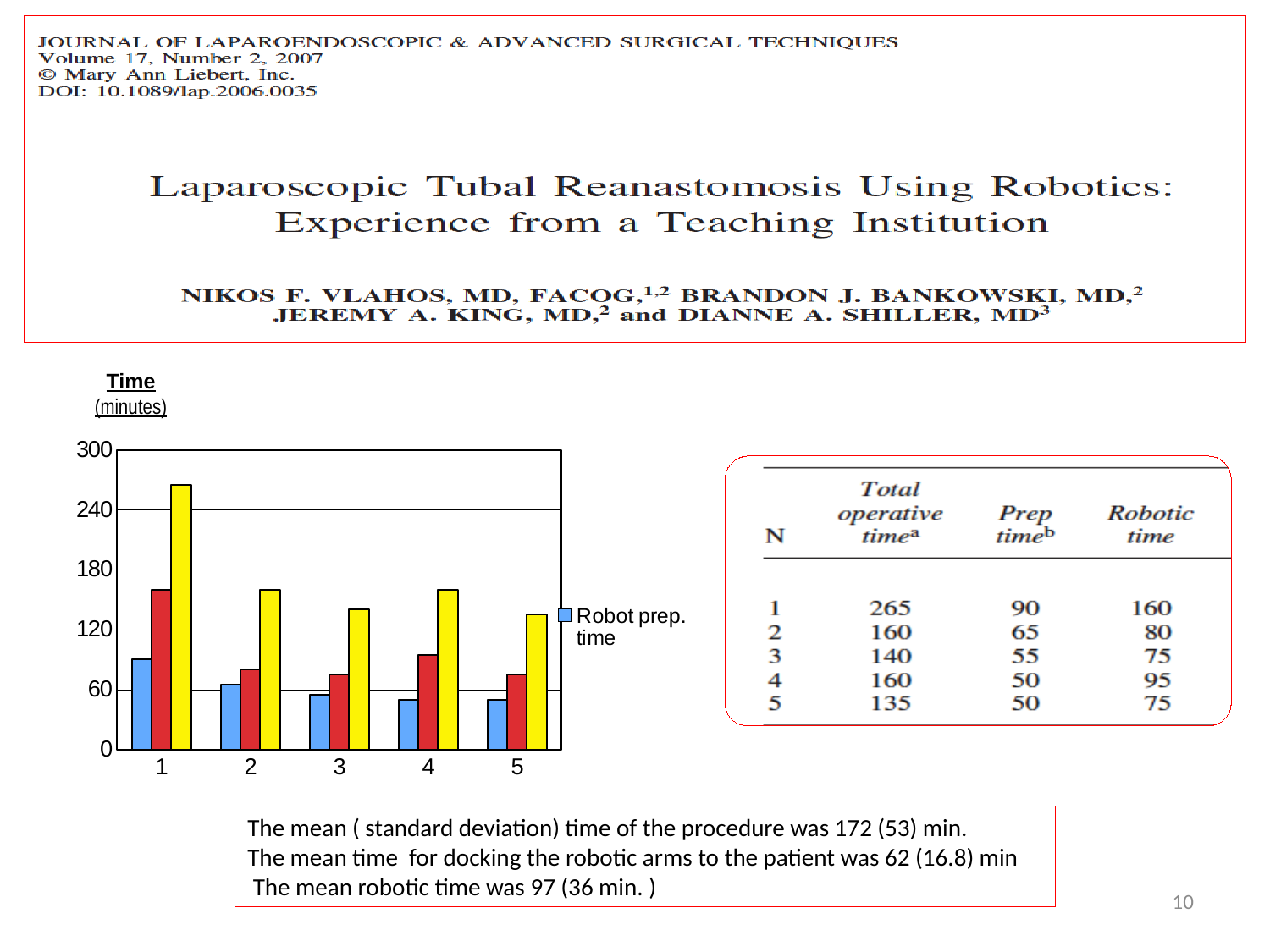
Do the Robot prep. time values generally rise or fall from category 1 to category 5? fall What series name is shown in the chart's legend? Robot prep. time What unit is the chart's y axis measured in, according to the axis label? minutes Is the yellow bar for category 5 greater or less than 180? less What kind of chart is shown on the slide? bar chart Which is larger, the red bar for category 1 or the red bar for category 4? category 1 How many categories are shown along the x axis of the chart? 5 For which category is the yellow bar the tallest? 1 Is the Robot prep. time value for category 1 greater or less than 60? greater Is the Robot prep. time value for category 1 greater or less than 120? less For which category is the Robot prep. time bar the highest? 1